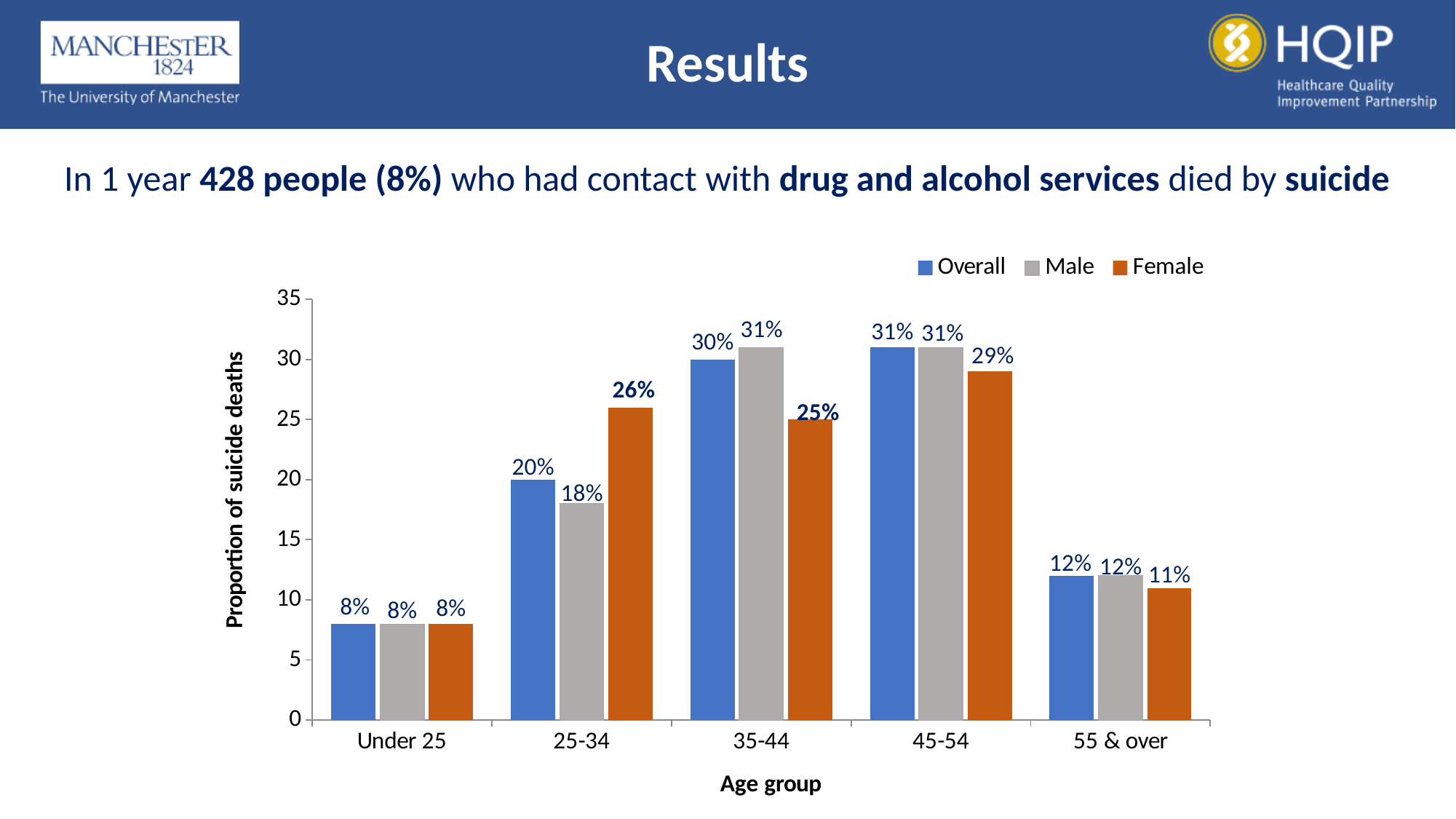
Which is larger for the 35-44 age group, the Male value or the Female value? Male Which colour represents the Female series? Orange Which age group has the highest Female value? 45-54 How many age groups are shown on the x axis? 5 Which age group has the lowest Overall value? Under 25 What is the Female value for the 25-34 age group? 26% How many series does the legend list? 3 What is the Overall value for the 55 & over age group? 12% What is the Male value for the 35-44 age group? 31% What is the difference between the Female and Male values for the 25-34 age group? 8% What is the label of the y axis? Proportion of suicide deaths What kind of chart is shown on the slide? Bar chart